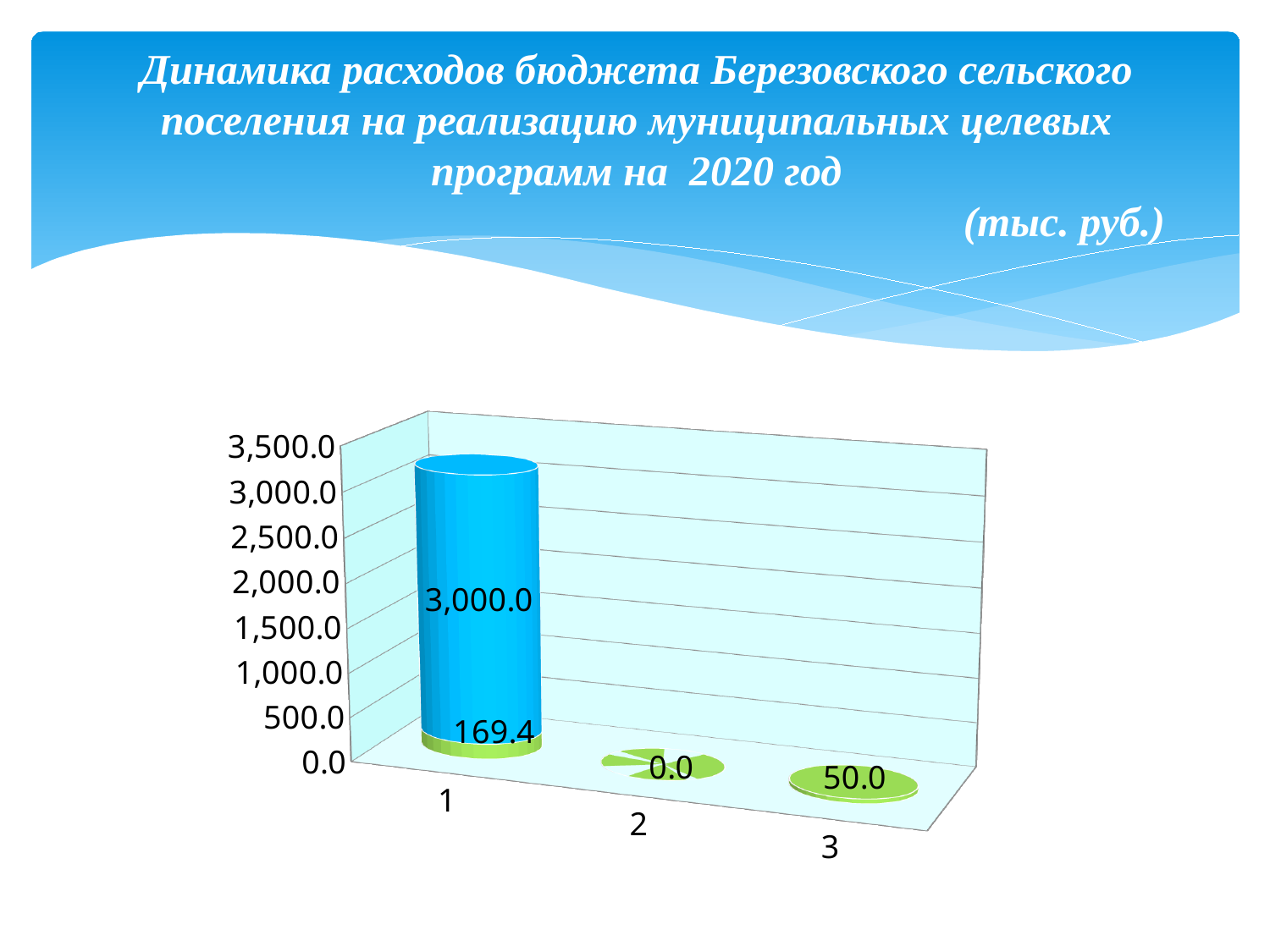
What is the value of the green segment for category 1? 169.4 What value is labelled for category 2? 0.0 Which category has the tallest bar? 1 What kind of chart is shown on the slide? bar chart What is the total of the stacked bar for category 1? 3,169.4 What is the highest value shown on the vertical axis? 3,500.0 How many categories are shown on the x axis? 3 Which is larger: the value for category 3 or the value for category 2? category 3 What is the difference between the blue segment (3,000.0) and the green segment (169.4) of category 1? 2,830.6 Which category has the lowest labelled value? 2 What is the value of the blue segment for category 1? 3,000.0 What value is labelled for category 3? 50.0